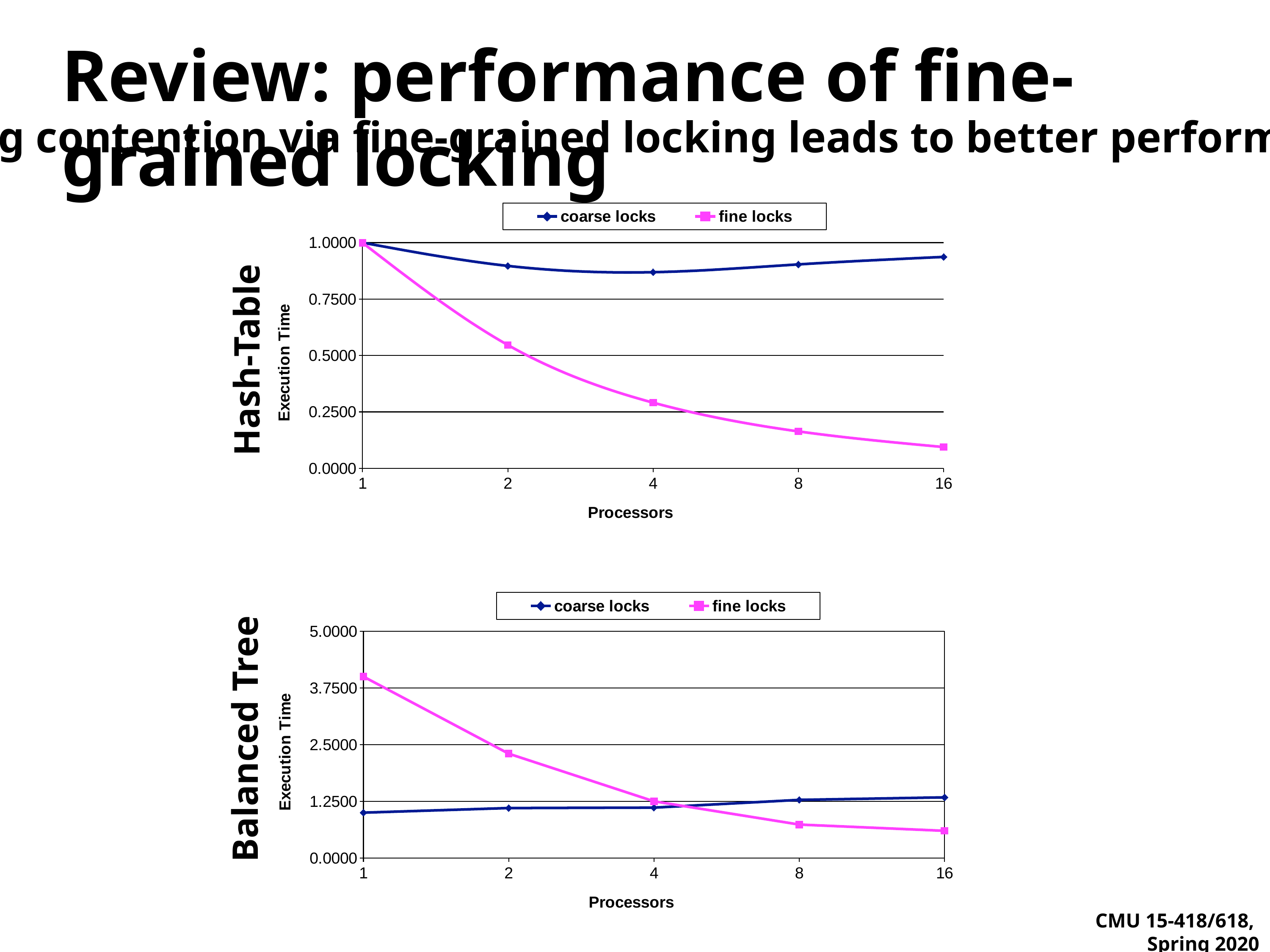
In the Balanced Tree chart, at which processor count is the fine locks execution time lowest? 16 What kind of chart is the Hash-Table chart? line chart In the Hash-Table chart, is the coarse locks value at 4 processors greater or less than 0.7500? greater In the Balanced Tree chart, which series has the larger execution time at 2 processors, coarse locks or fine locks? fine locks How many series does the legend of the Balanced Tree chart list? 2 In the Hash-Table chart, which series has the larger execution time at 8 processors, coarse locks or fine locks? coarse locks In the Hash-Table chart, is the fine locks value at 16 processors greater or less than 0.2500? less In the Hash-Table chart, does the fine locks execution time rise or fall as the number of processors increases? fall In the Balanced Tree chart, is the fine locks value at 1 processor greater or less than 3.7500? greater How many processor counts are plotted along the x axis of the Hash-Table chart? 5 What is the label of the y axis on the Balanced Tree chart? Execution Time